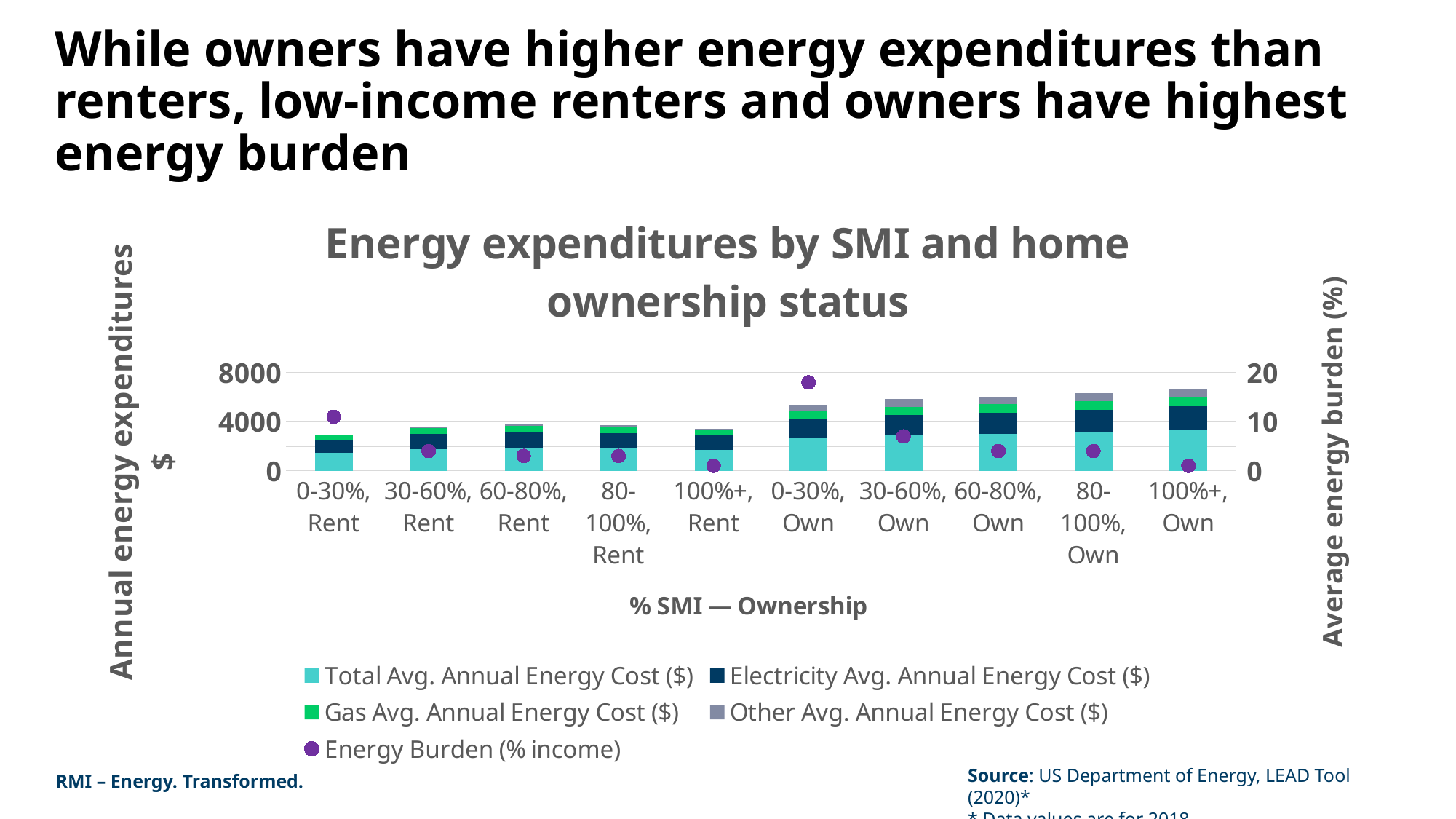
Is the total height of the stacked bar for 0-30%, Rent greater or less than 4000? less Is the Energy Burden (% income) for 0-30%, Own greater or less than 10? greater What is the title of the chart? Energy expenditures by SMI and home ownership status What kind of chart is used to show the energy cost values? Bar chart How many categories are shown on the x axis? 10 Across the Rent categories from 0-30% to 100%+, does the Energy Burden (% income) rise or fall? fall Is the total height of the stacked bar for 0-30%, Own greater or less than 4000? greater What is the label of the right-hand vertical axis? Average energy burden (%) Which has a taller stacked bar, 0-30%, Rent or 0-30%, Own? 0-30%, Own How many series does the legend list? 5 Which category has the highest Energy Burden (% income)? 0-30%, Own